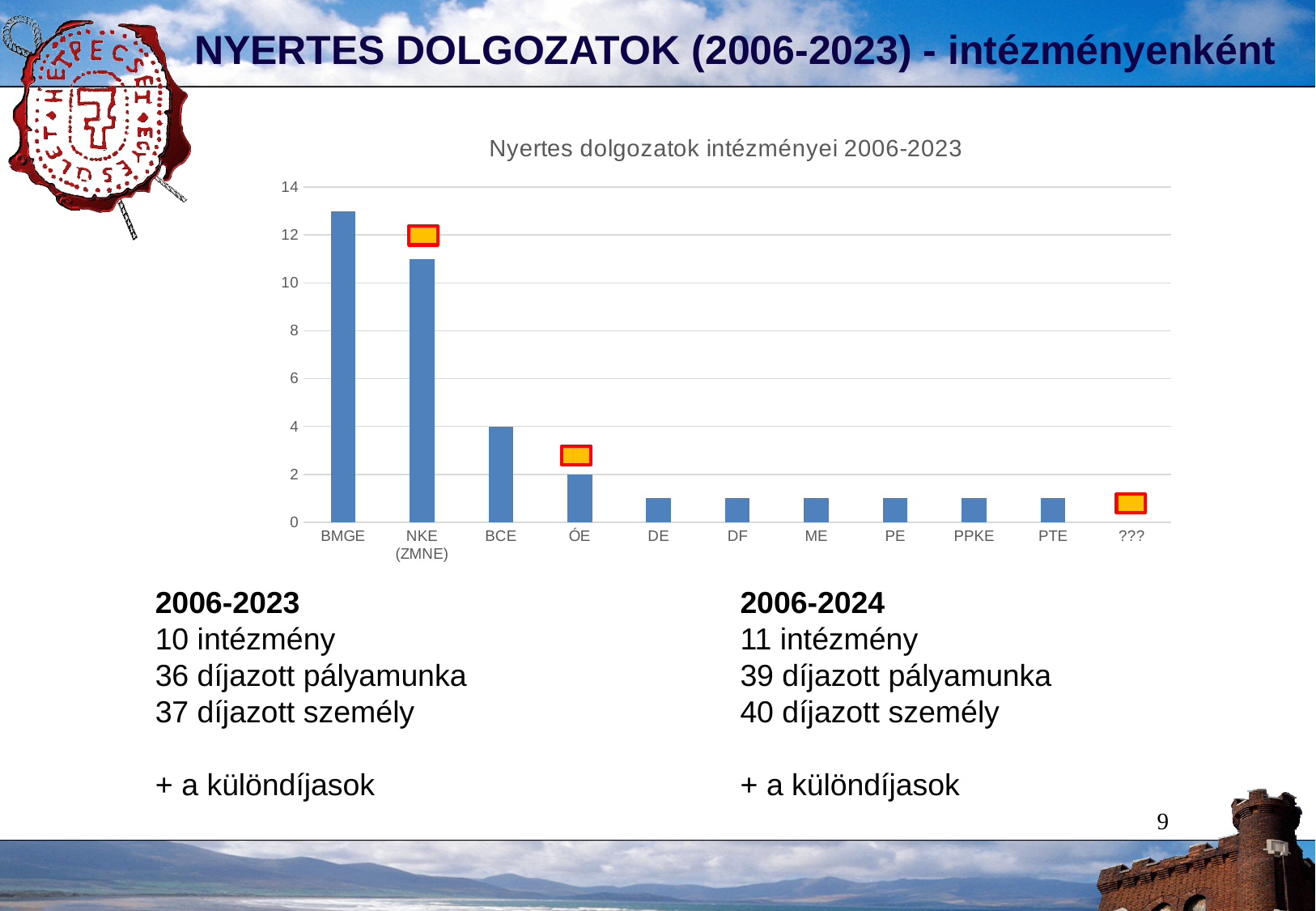
What is the value for BCE in the chart? 4 What kind of chart is shown on the slide? bar chart What is the title of the chart? Nyertes dolgozatok intézményei 2006-2023 Is the value for DE greater or less than 2? less How many categories are shown on the x axis of the chart? 11 Is the value for NKE (ZMNE) greater or less than 10? greater Do the bar values generally rise or fall from left to right along the x axis? fall Which is larger, the value for BMGE or the value for NKE (ZMNE)? BMGE What is the difference between the values for BCE and ÓE? 2 Is the value for BMGE greater or less than 12? greater What is the value for ÓE in the chart? 2 Which category has the highest bar in the chart? BMGE